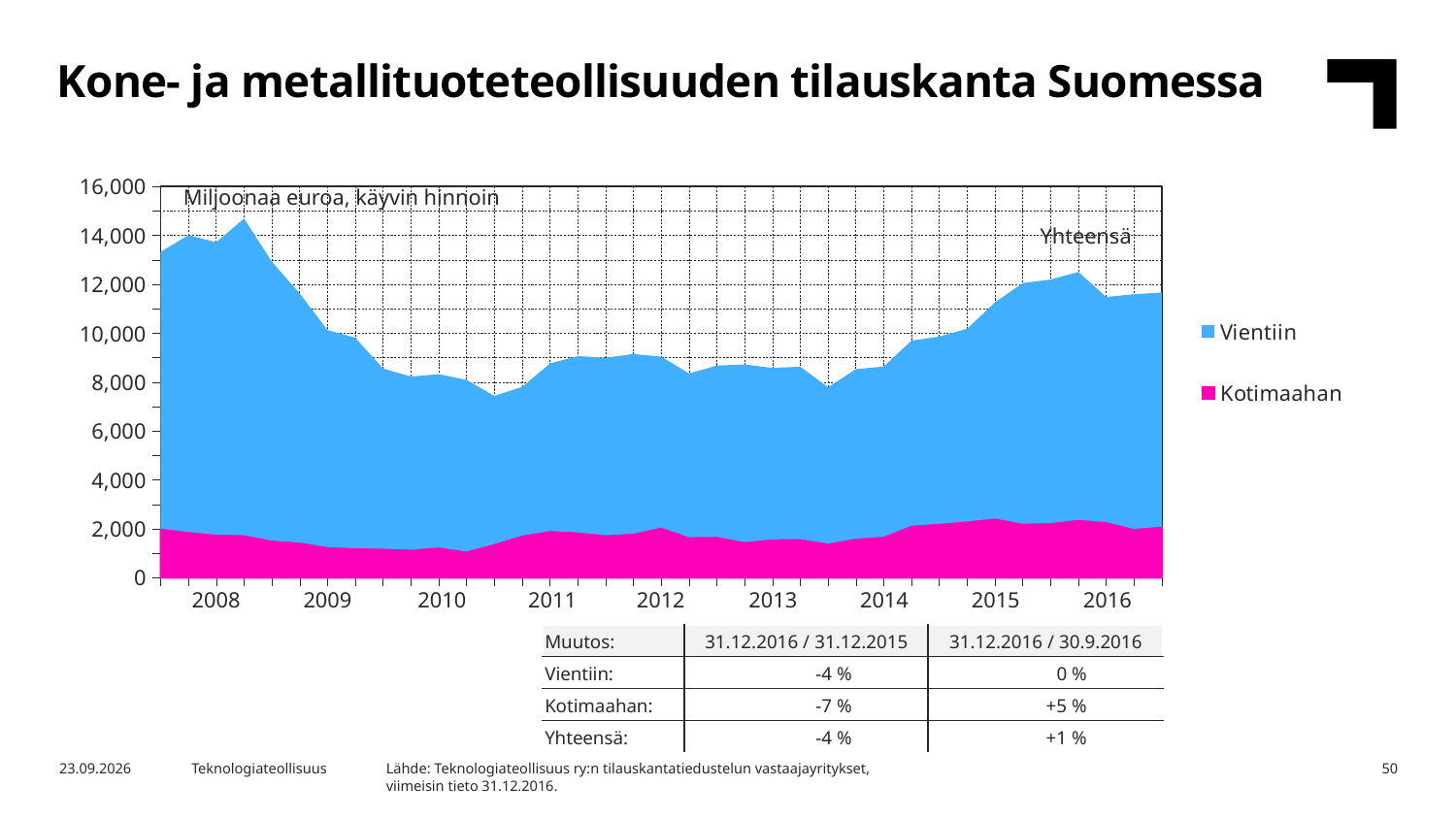
Is the total value in 2010 greater or less than 10,000? less In which year does the total order backlog (Yhteensä) reach its highest level? 2008 How many year labels are shown on the x axis? 9 Is the peak total value in 2008 greater or less than 14,000? greater Which two series are listed in the chart legend? Vientiin and Kotimaahan How many series does the chart legend list? 2 Which series is larger throughout the chart, Vientiin or Kotimaahan? Vientiin What unit label is printed inside the chart area? Miljoonaa euroa, käyvin hinnoin What kind of chart is shown on the slide? Stacked area chart Is the Kotimaahan value at any point greater or less than 4,000? less Does the total order backlog rise or fall from 2013 to 2015? rise Does the total order backlog rise or fall from 2008 to 2010? fall